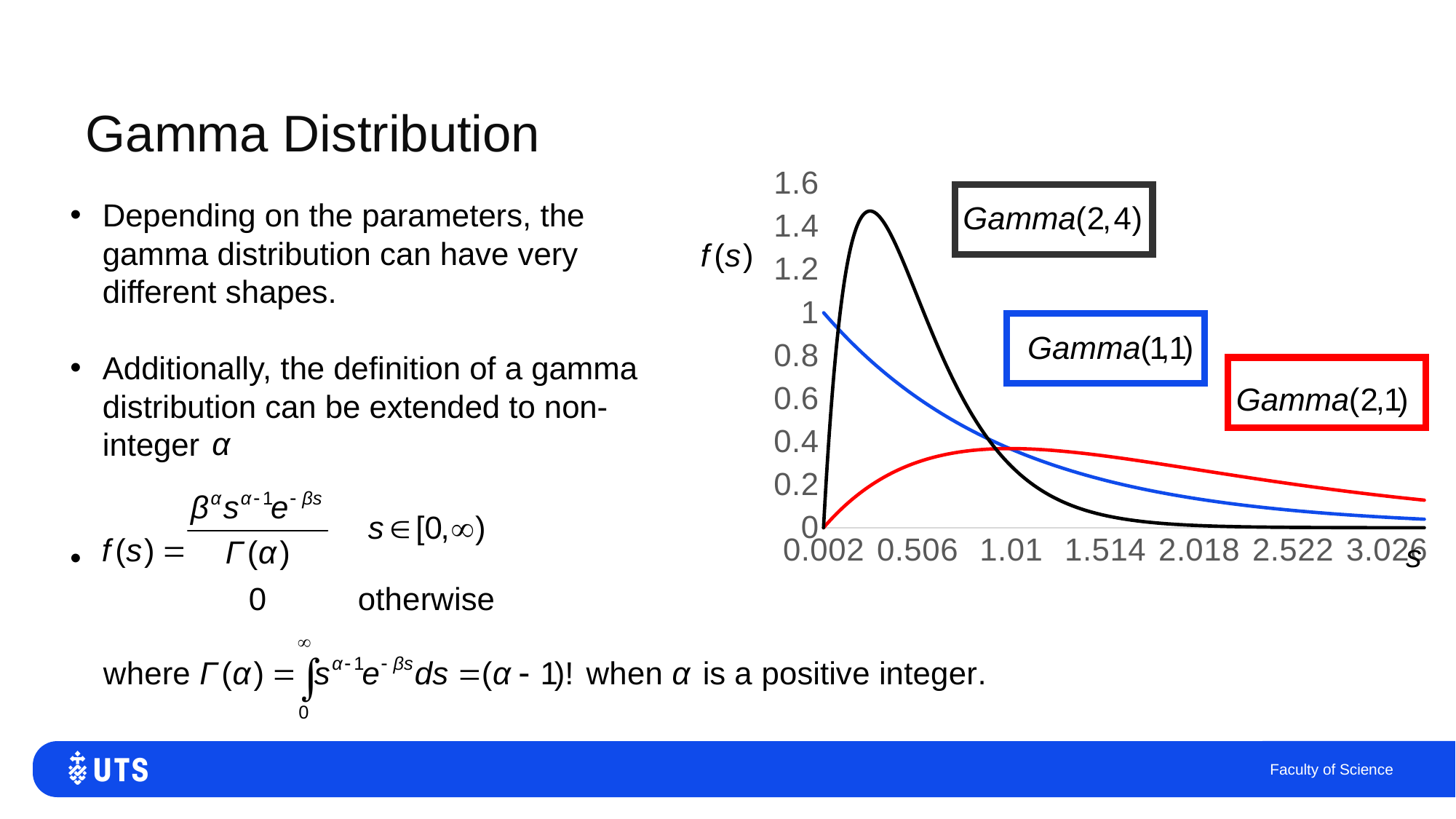
How many curves (series) are plotted on the chart? 3 Which curve has the highest value at the right end of the x axis (s = 3.026)? Gamma(2,1) Is the peak value of the Gamma(2,4) curve greater or less than 1.2? greater Which curve has the highest value at the left end of the x axis (s = 0.002)? Gamma(1,1) Which curve reaches the highest peak value on the chart? Gamma(2,4) Is the value of the Gamma(1,1) curve at s = 1.01 greater or less than 0.6? less What kind of chart is shown on the slide? line chart How many tick labels are shown on the x axis? 7 Does the Gamma(1,1) curve rise or fall as s increases along the x axis? fall What colour is the Gamma(2,1) curve? red What is the label on the y axis of the chart? f(s) Is the peak value of the Gamma(2,1) curve greater or less than 0.6? less